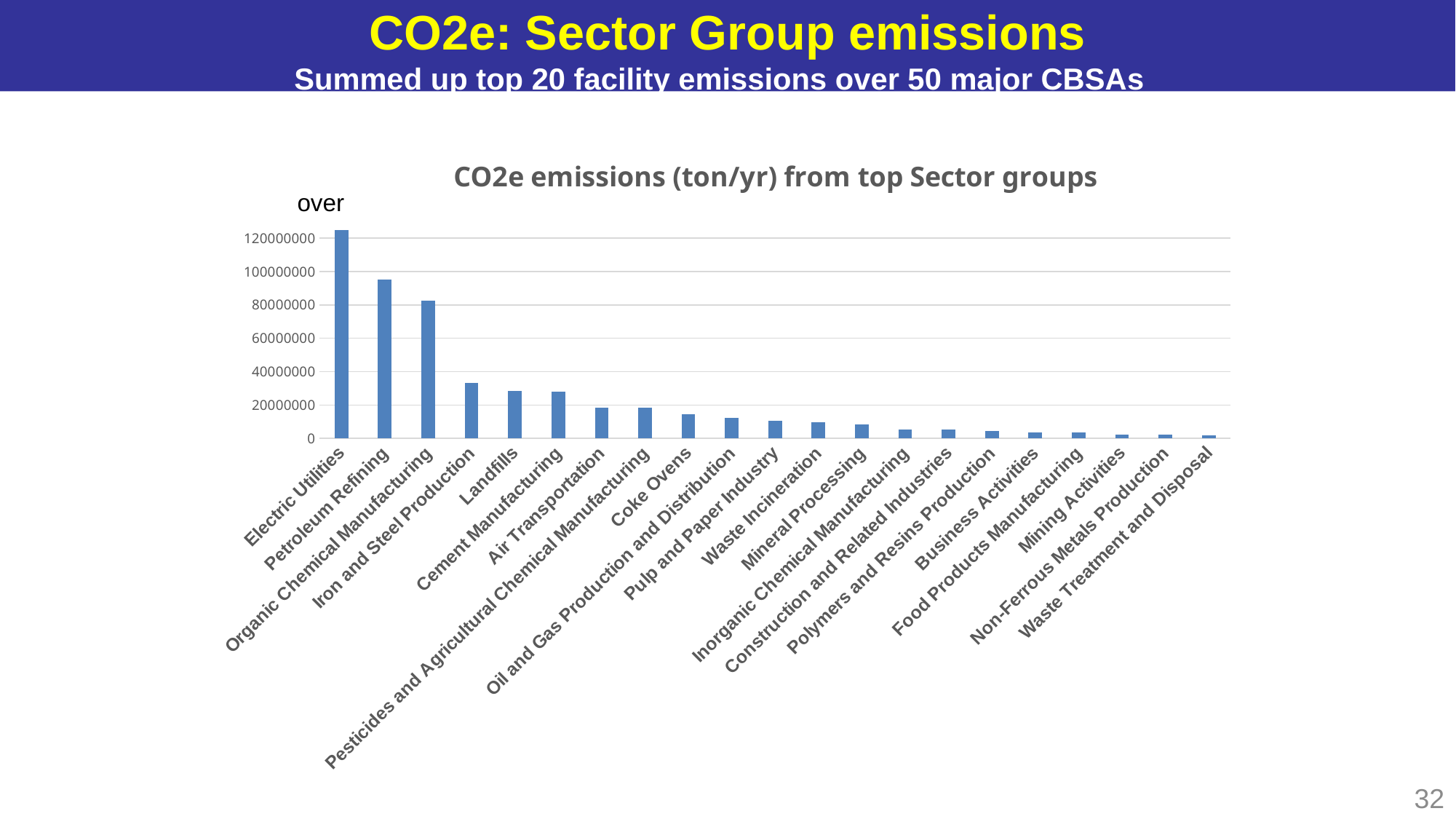
Which has higher CO2e emissions, Petroleum Refining or Organic Chemical Manufacturing? Petroleum Refining Which sector group has the highest CO2e emissions? Electric Utilities What is the title of the chart? CO2e emissions (ton/yr) from top Sector groups Is the value for Electric Utilities greater or less than 120000000? greater Is the value for Iron and Steel Production greater or less than 40000000? less Which sector group has the lowest CO2e emissions? Waste Treatment and Disposal How many sector groups are plotted in the chart? 21 Is the value for Landfills greater or less than 20000000? greater Do the values rise or fall moving from left to right along the x axis? fall What kind of chart is shown on the slide? bar chart